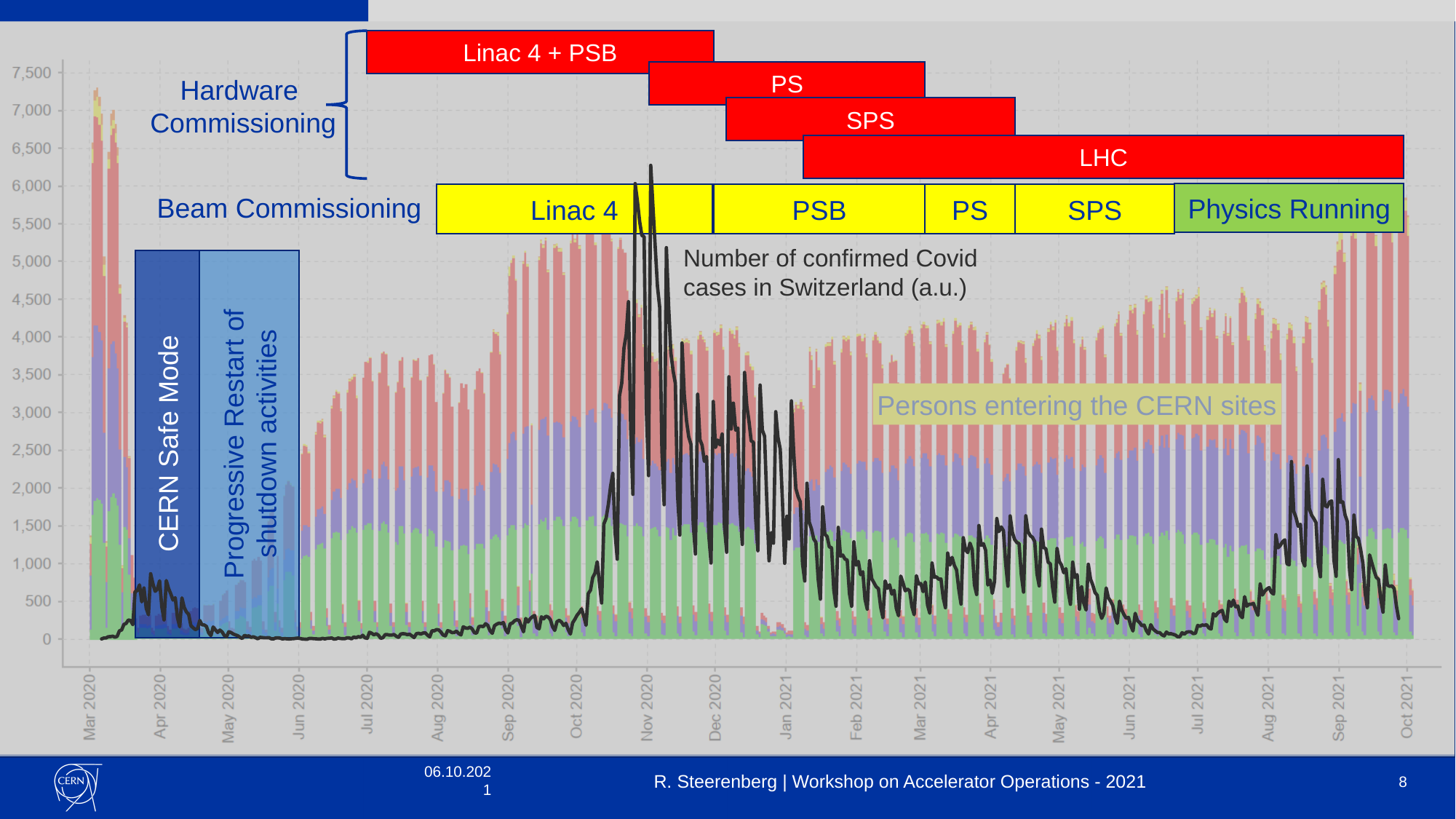
What do the stacked coloured bars on the chart represent? Persons entering the CERN sites Is the value of the black Covid line at Jul 2021 greater or less than 500? less What does the black line on the chart represent? Number of confirmed Covid cases in Switzerland (a.u.) Is the highest peak of the black Covid line greater or less than 5,500? greater Is the tallest bar in Mar 2020 greater or less than 7,000? greater How many month labels are shown on the x axis? 20 What is the highest value labelled on the y axis? 7,500 Between Jun 2021 and Aug 2021, does the black Covid line rise or fall? rise In which month does the black Covid line reach its highest peak? Nov 2020 Is the peak of the black Covid line in Nov 2020 higher or lower than its peak in Sep 2021? higher What kind of chart is shown on the slide? bar chart with a line overlay